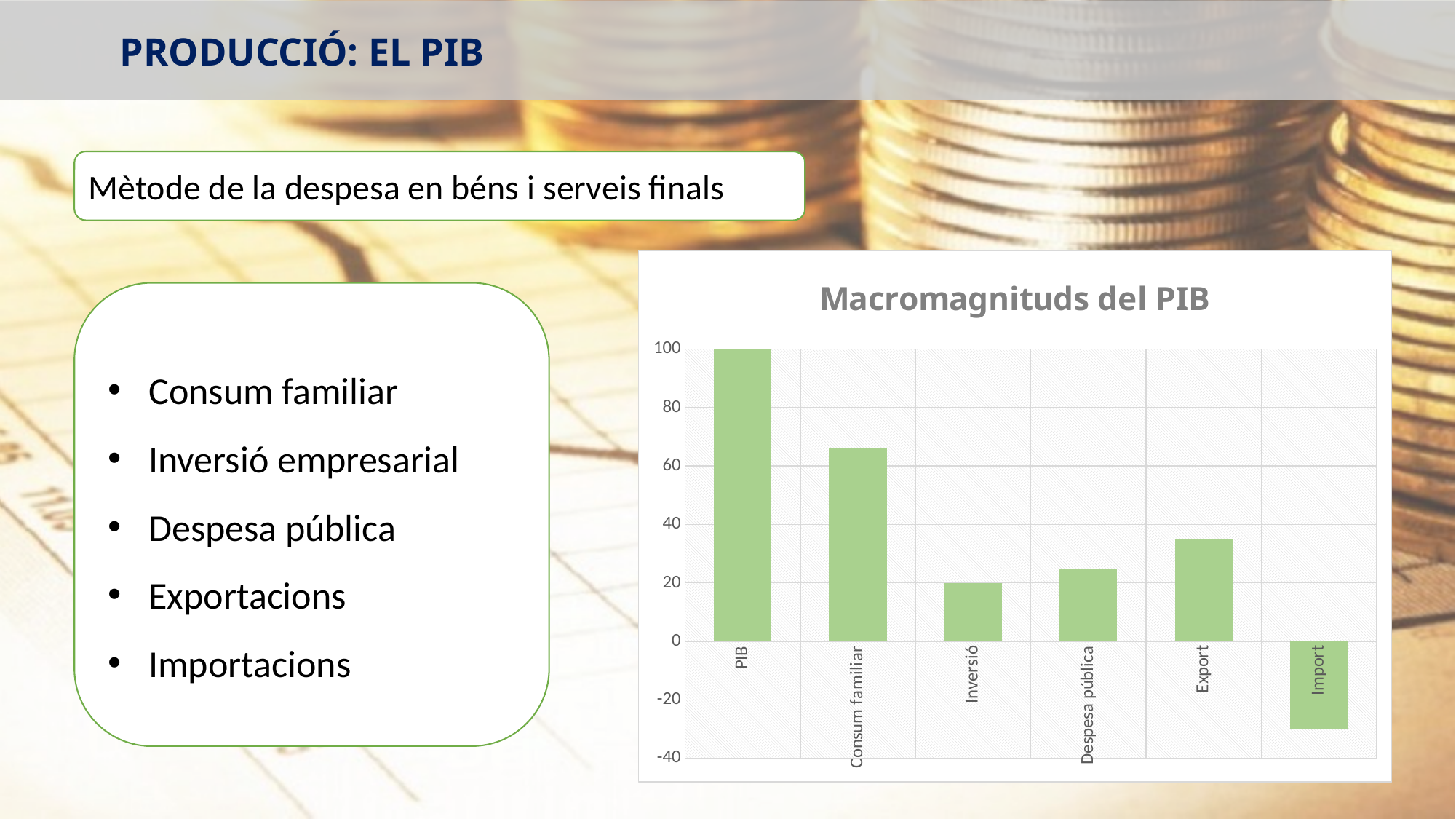
What is the value for PIB in the Macromagnituds del PIB chart? 100 What is the title of the chart on the slide? Macromagnituds del PIB Which category has the lowest value in the Macromagnituds del PIB chart? Import How many categories are shown in the Macromagnituds del PIB chart? 6 What is the value for Inversió in the Macromagnituds del PIB chart? 20 What kind of chart is shown on the slide? Bar chart Is the value for Import greater or less than -20? less Which category has the highest value in the Macromagnituds del PIB chart? PIB Is the value for Export greater or less than 20? greater Is the value for Despesa pública greater or less than 40? less Which is larger, the value for Consum familiar or the value for Export? Consum familiar